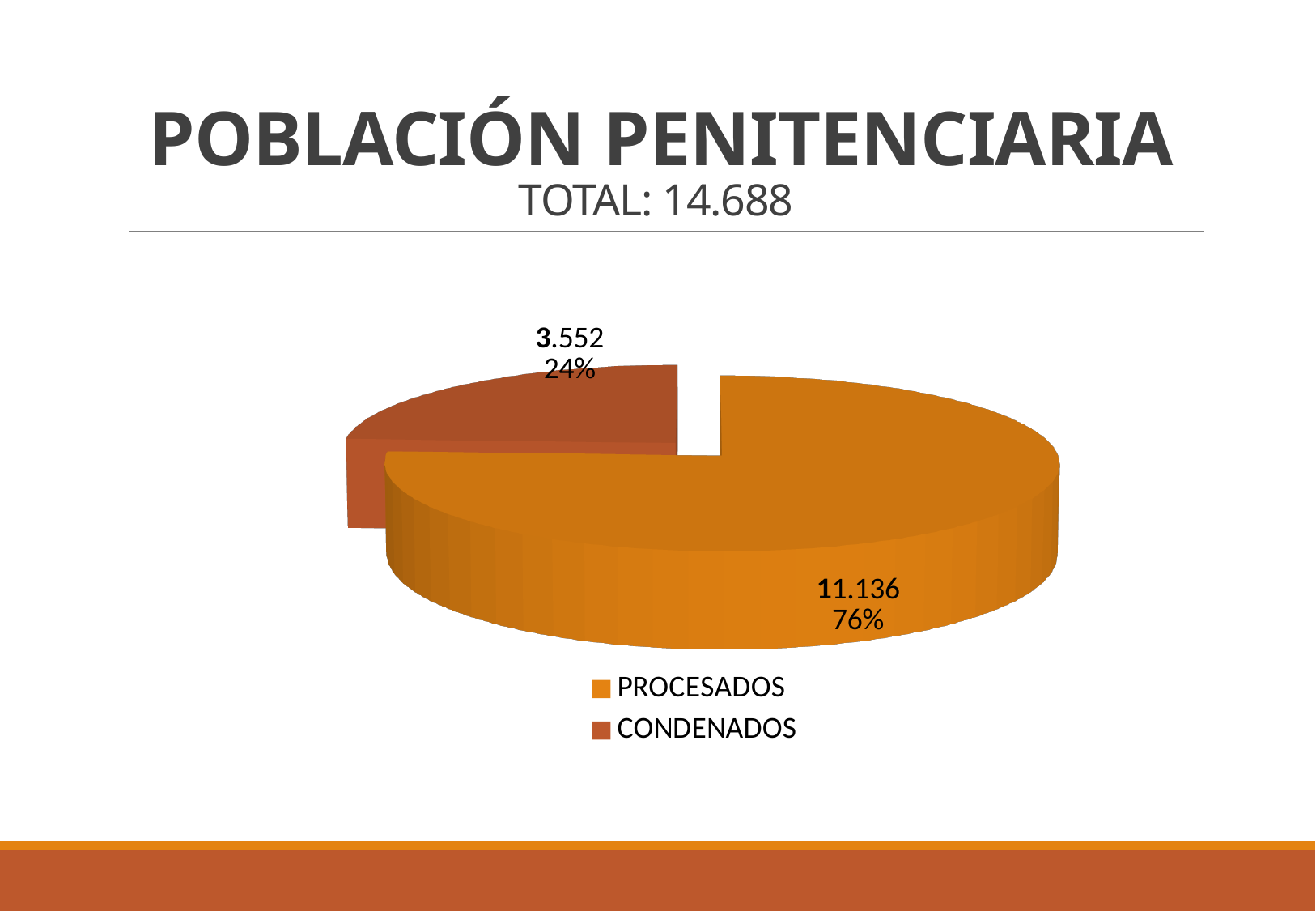
How many categories does the pie chart have? 2 Which category has the largest slice? PROCESADOS Which category has the smallest slice? CONDENADOS What is the value for PROCESADOS? 11.136 What kind of chart is shown on the slide? Pie chart What is the total shown on the slide for the prison population? 14.688 What share of the pie does CONDENADOS represent? 24% What share of the pie does PROCESADOS represent? 76% What is the value for CONDENADOS? 3.552 Which is larger, PROCESADOS or CONDENADOS? PROCESADOS Which legend entry is shown in the darker brown-orange colour? CONDENADOS What is the title of the slide? POBLACIÓN PENITENCIARIA